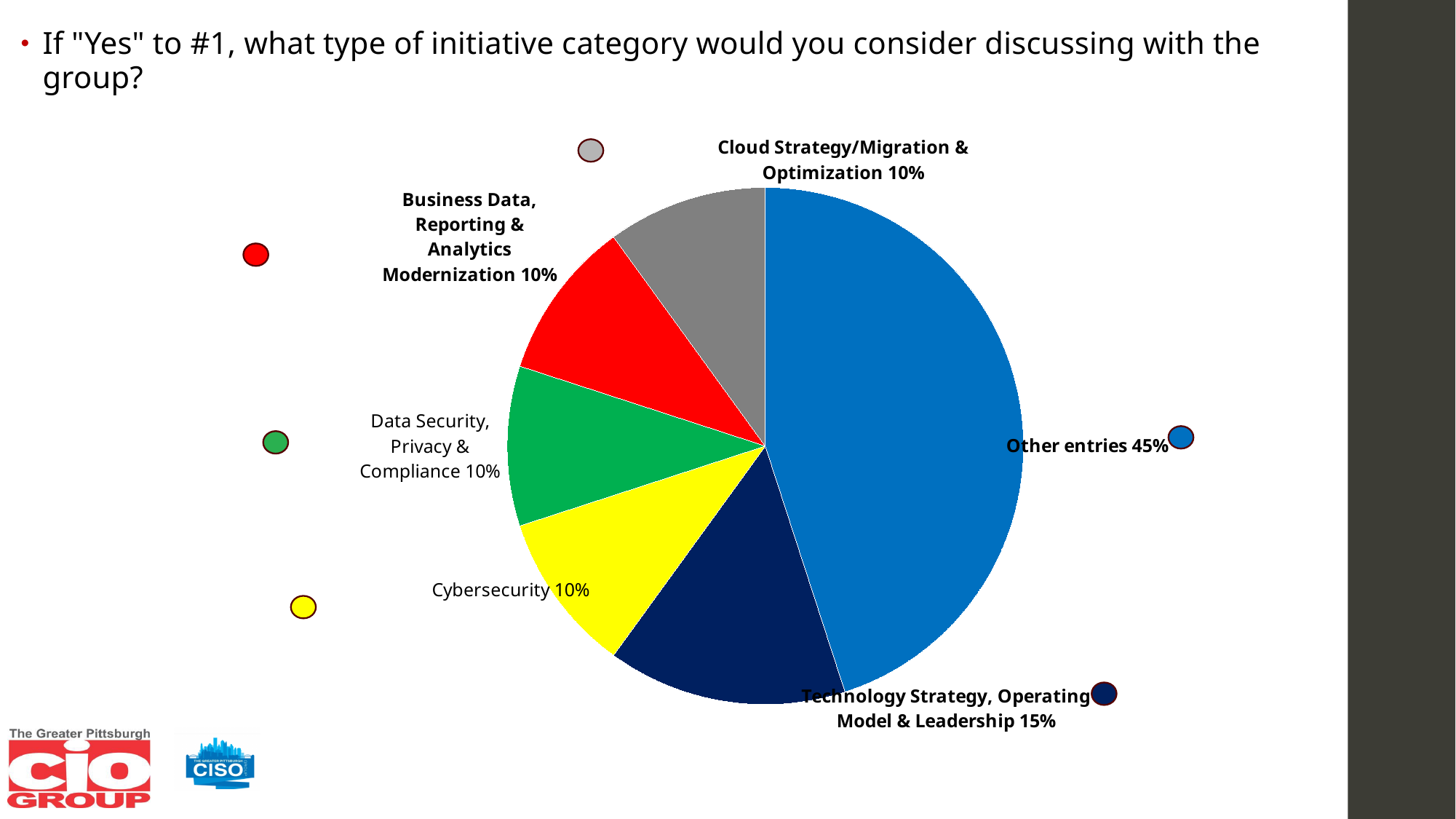
What is the combined share of Cybersecurity and Business Data, Reporting & Analytics Modernization? 20% What colour is the Cybersecurity slice? yellow What kind of chart is shown on the slide? pie chart What percentage is shown for Technology Strategy, Operating Model & Leadership? 15% What percentage is shown for Cybersecurity? 10% What percentage is shown for Cloud Strategy/Migration & Optimization? 10% Which category has the largest slice of the pie? Other entries What colour is the slice for Other entries? blue What share of the pie is labelled "Other entries"? 45% What is the difference between the Other entries share and the Technology Strategy, Operating Model & Leadership share? 30% How many slices does the pie chart have? 6 Which is larger: the share for Technology Strategy, Operating Model & Leadership or the share for Data Security, Privacy & Compliance? Technology Strategy, Operating Model & Leadership